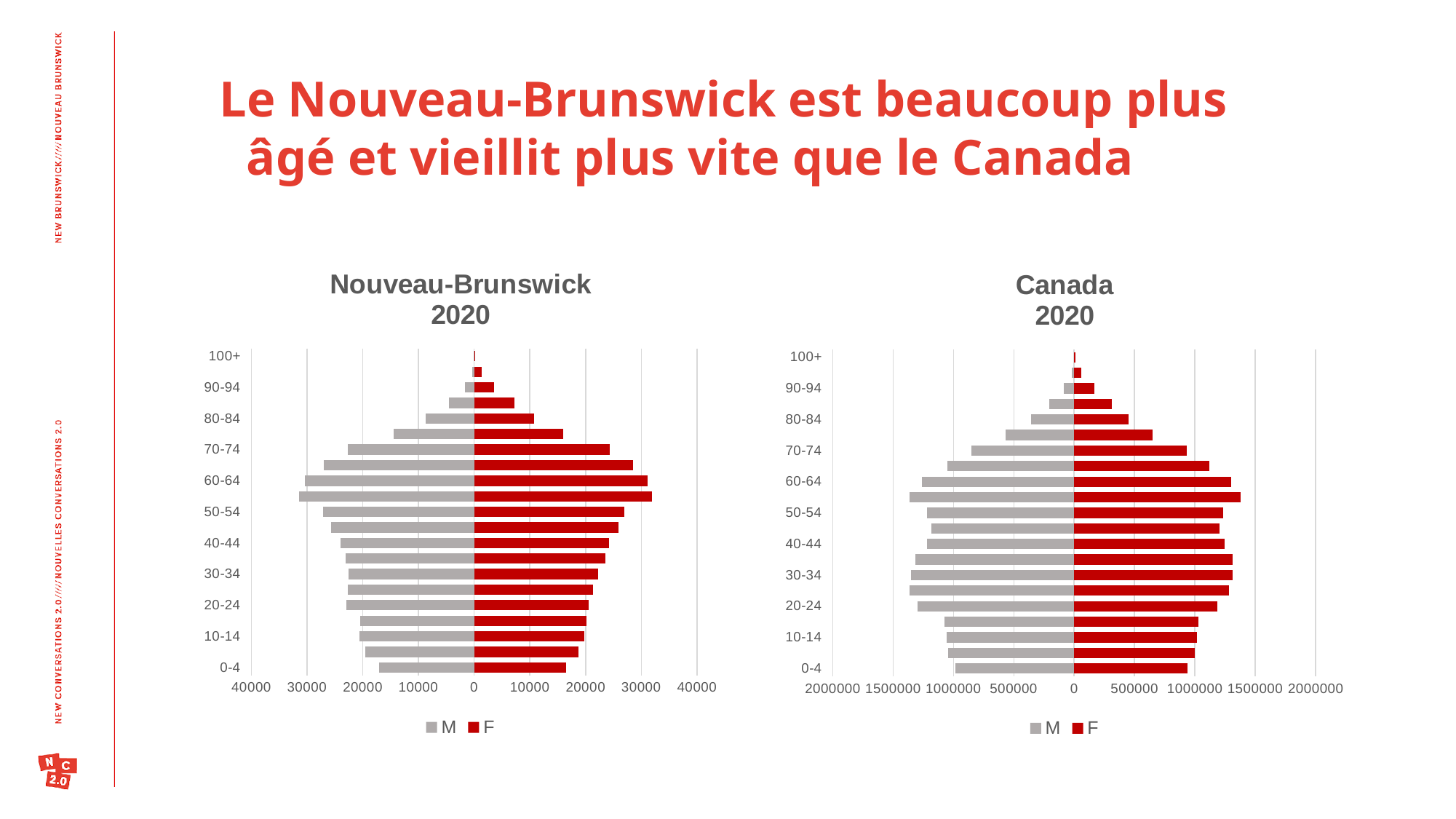
On the Nouveau-Brunswick 2020 chart, which age group has the larger F value, 70-74 or 0-4? 70-74 On the Nouveau-Brunswick 2020 chart, which is larger for the 80-84 age group, the M value or the F value? F What kind of chart is the Nouveau-Brunswick 2020 chart? bar chart What is the highest value shown on the horizontal axis of the Canada 2020 chart? 2000000 What are the two legend entries on the Nouveau-Brunswick 2020 chart? M and F How many series does the legend of the Canada 2020 chart list? 2 On the Canada 2020 chart, which age group has the larger F value, 60-64 or 80-84? 60-64 On the Nouveau-Brunswick 2020 chart, is the F value for 70-74 greater or less than 20000? greater On the Canada 2020 chart, is the F value for 60-64 greater or less than 1000000? greater On the Canada 2020 chart, is the M value for 80-84 greater or less than 500000? less On the Nouveau-Brunswick 2020 chart, which colour represents the F series? red